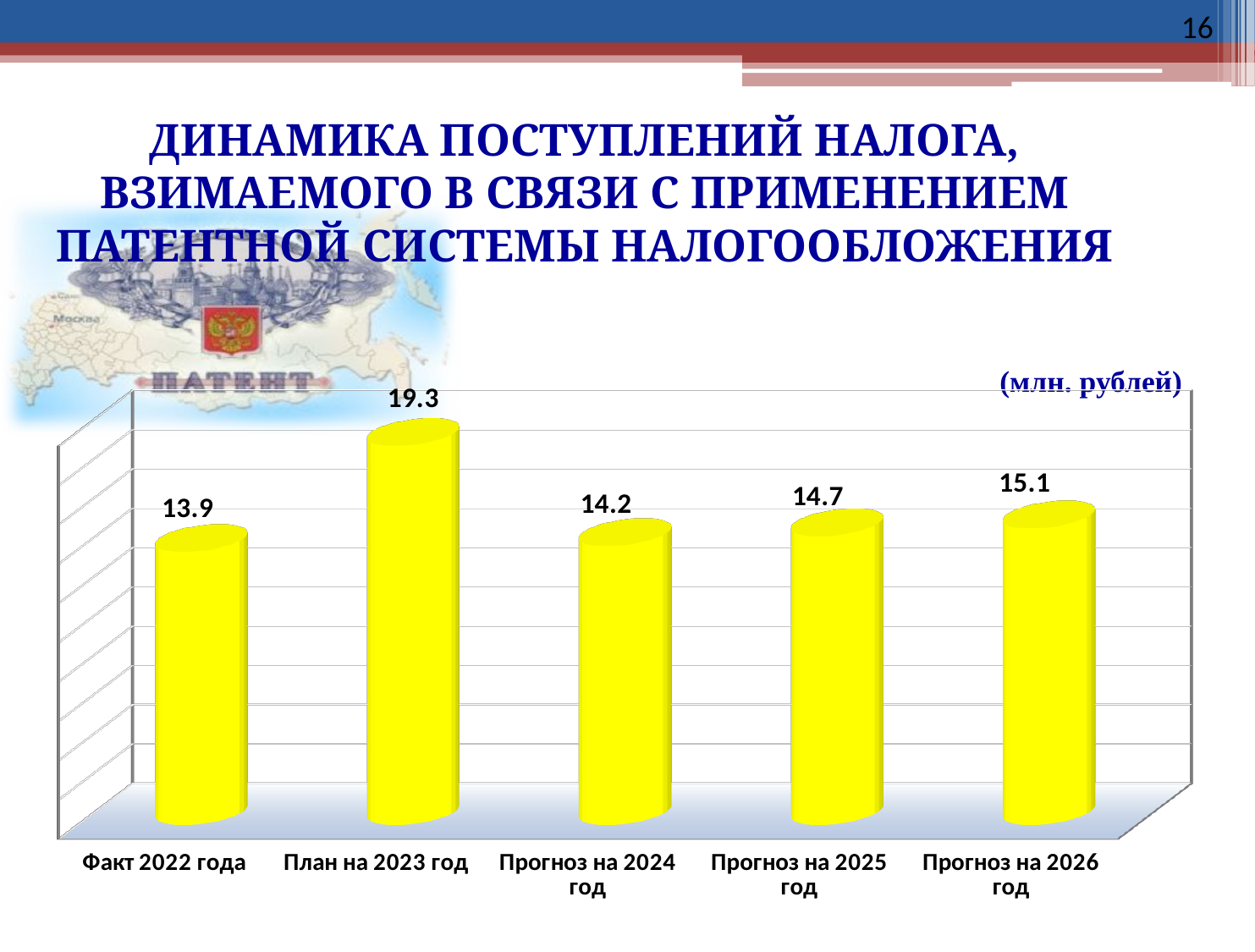
What is the difference between the values for Прогноз на 2026 год and Прогноз на 2024 год? 0.9 Which category has the highest value? План на 2023 год How many categories are shown in the chart? 5 Which is larger, the value for Прогноз на 2025 год or the value for Прогноз на 2024 год? Прогноз на 2025 год What is the value for Факт 2022 года? 13.9 What unit is indicated for the values in the chart? млн. рублей What is the value for Прогноз на 2026 год? 15.1 What kind of chart is shown on the slide? Bar chart What is the value for План на 2023 год? 19.3 What is the difference between the values for План на 2023 год and Факт 2022 года? 5.4 Which category has the lowest value? Факт 2022 года Do the values rise or fall from Прогноз на 2024 год to Прогноз на 2026 год? Rise